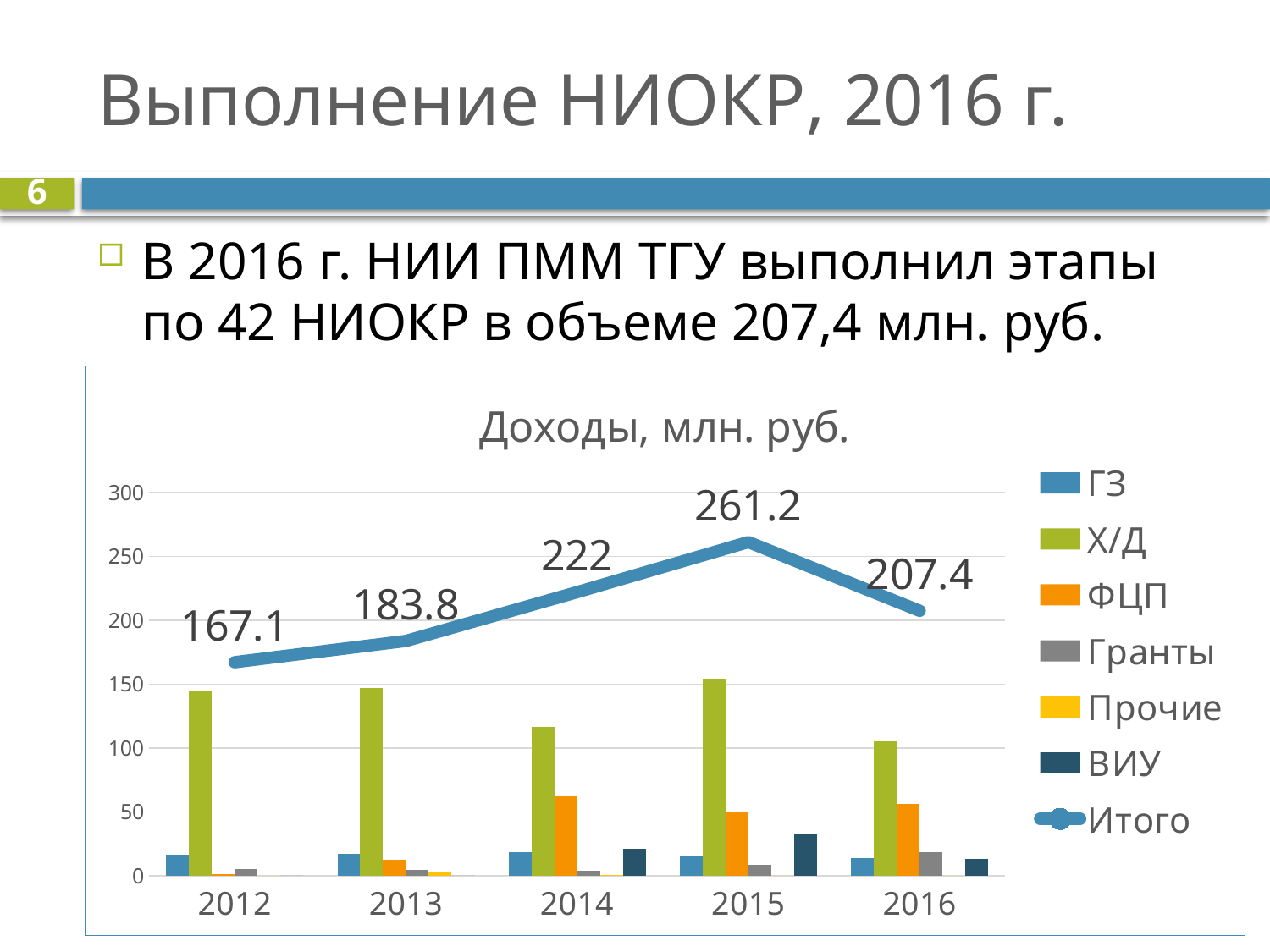
Is the ФЦП bar for 2014 greater or less than 50? greater Which is larger, the Итого value for 2014 or for 2013? 2014 In which year is the Итого line at its highest? 2015 What is the value of the Итого line for 2015? 261.2 What is the value of the Итого line for 2016? 207.4 In which year is the Итого line at its lowest? 2012 What is the difference between the Итого values for 2015 and 2016? 53.8 How many series does the legend list? 7 What is the title of the chart? Доходы, млн. руб. How many years are shown on the x axis? 5 What is the value of the Итого line for 2012? 167.1